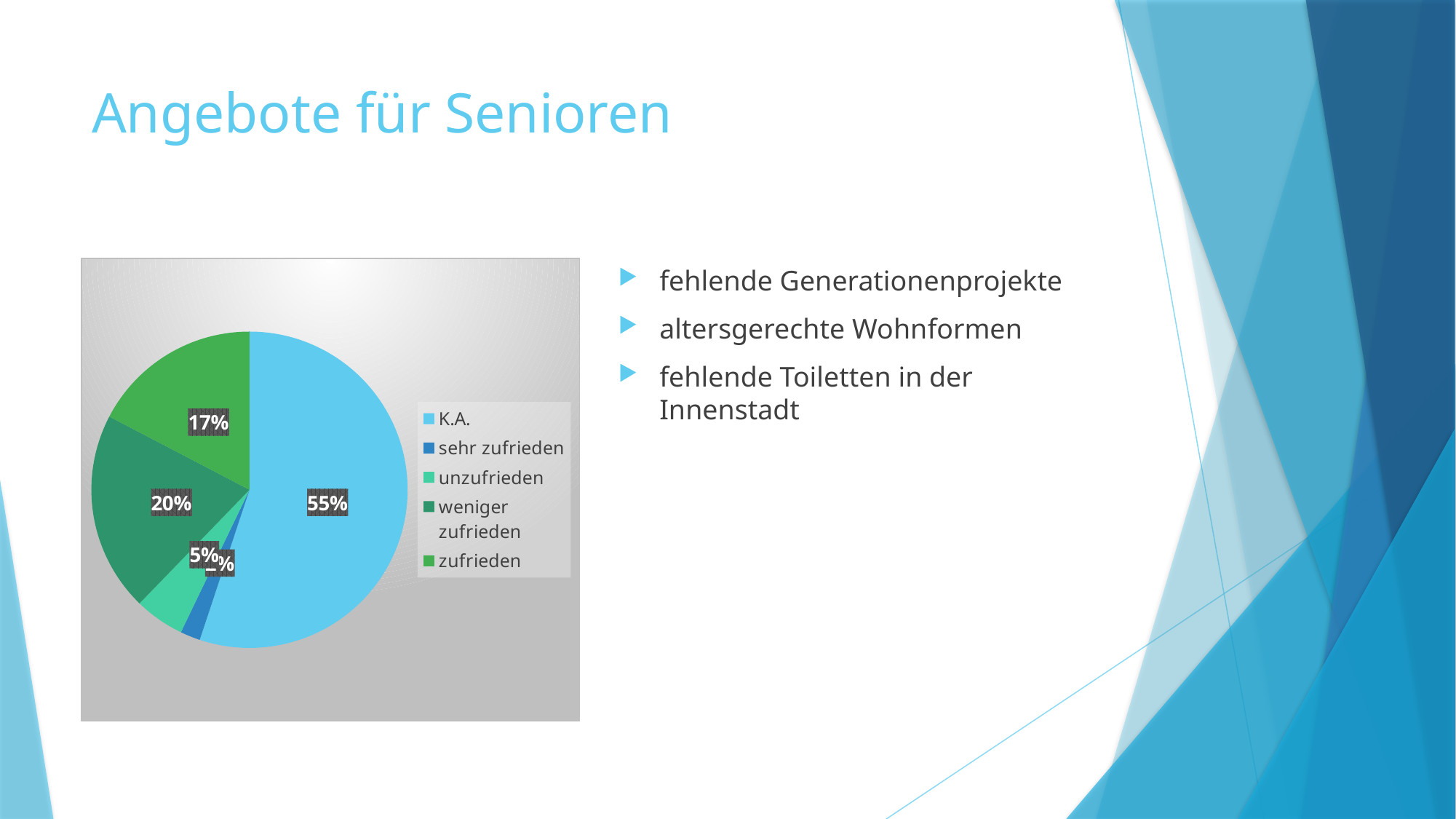
Which legend entry appears first in the pie chart's legend? K.A. By how many percentage points is the K.A. slice larger than the "weniger zufrieden" slice? 35 percentage points What type of chart is shown on the slide? Pie chart What percentage is shown for "unzufrieden" in the pie chart? 5% What percentage of the pie chart is labelled K.A.? 55% How many categories does the pie chart's legend list? 5 What colour is the K.A. slice in the pie chart? Light blue What share does the "weniger zufrieden" slice show in the pie chart? 20% Which category has the smallest slice in the pie chart? sehr zufrieden Which slice is larger: "weniger zufrieden" or "zufrieden"? weniger zufrieden What percentage is shown for "zufrieden" in the pie chart? 17% Which category has the largest slice in the pie chart? K.A.